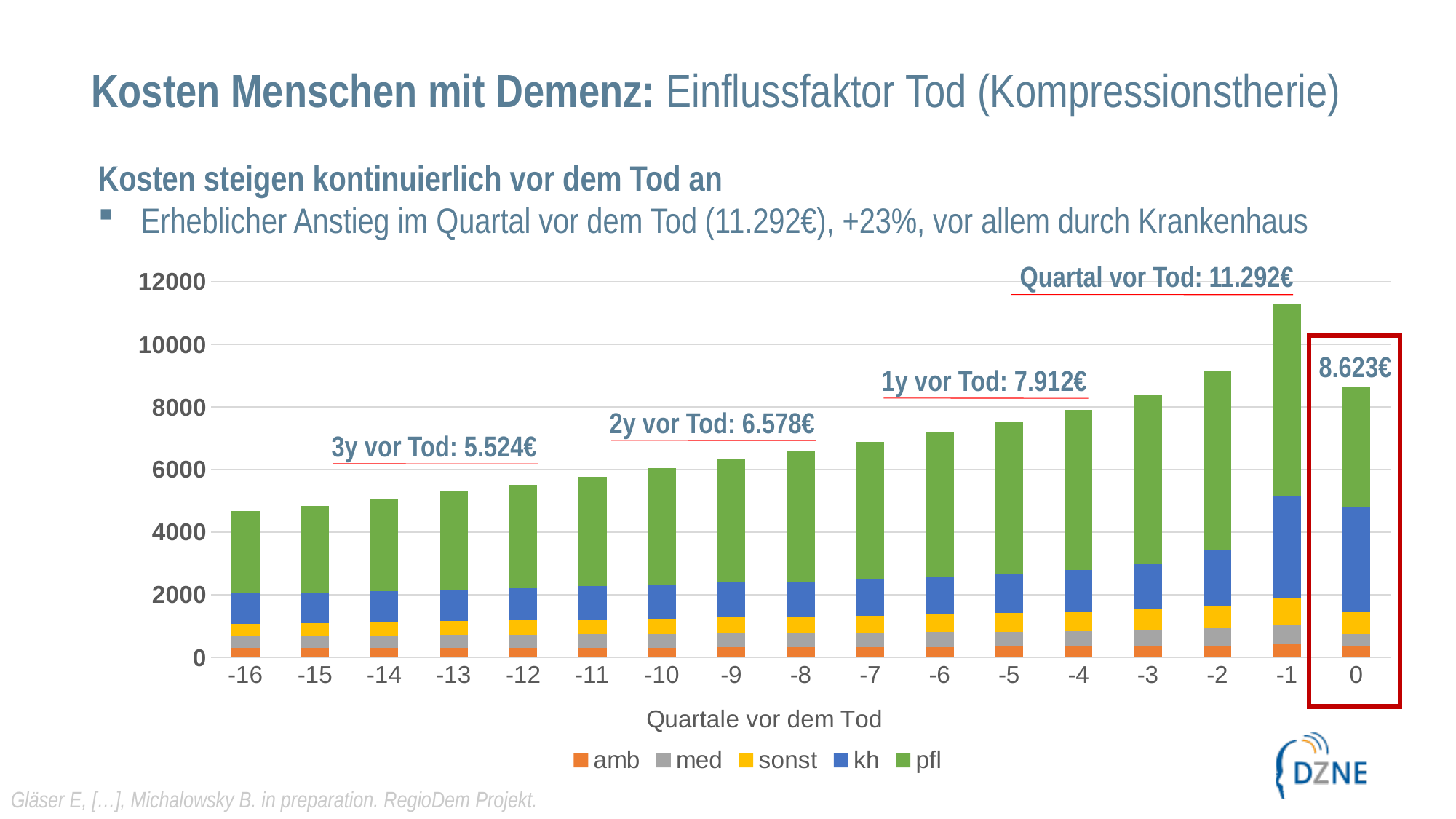
Which quarter has the highest total bar? -1 What is the difference between the labelled value for the quarter before death (11.292€) and the labelled value for quarter 0 (8.623€)? 2.669€ Is the total bar for quarter -16 greater or less than 6000? less Which quarter has the lowest total bar? -16 How many quarters (categories) are plotted on the x axis? 17 What is the title of the x axis? Quartale vor dem Tod What total cost does the annotation give for the quarter before death ("Quartal vor Tod")? 11.292€ What total cost is labelled for quarter 0? 8.623€ Do the total costs rise or fall from quarter -16 to quarter -1? rise What kind of chart is shown on the slide? bar chart How many series does the legend list? 5 What value does the annotation "1y vor Tod" give? 7.912€